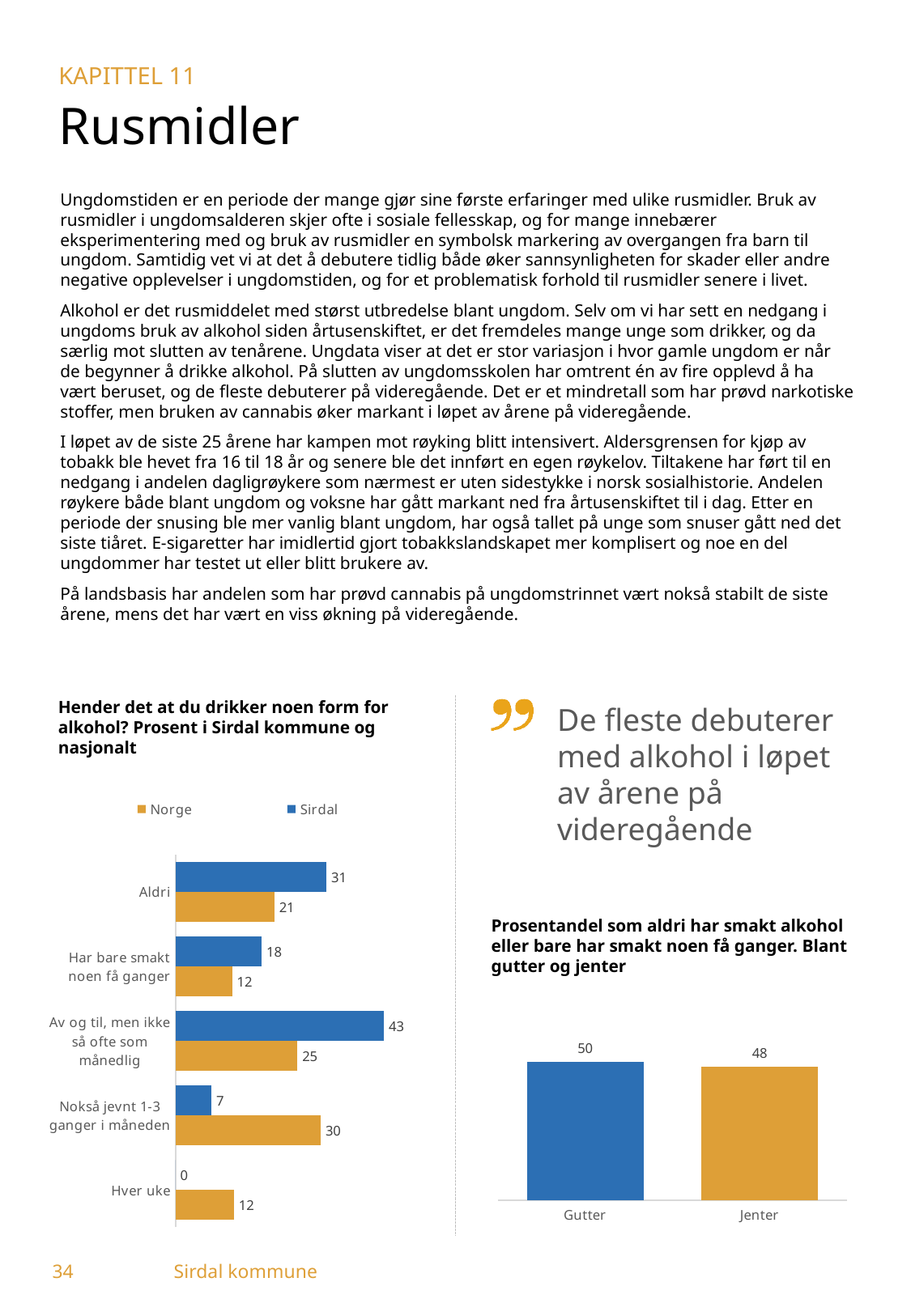
How many categories are shown in the chart 'Hender det at du drikker noen form for alkohol?'? 5 In the chart 'Hender det at du drikker noen form for alkohol?', what is the value for Sirdal in the category 'Hver uke'? 0 What kind of chart is the chart 'Hender det at du drikker noen form for alkohol?'? Bar chart In the chart 'Hender det at du drikker noen form for alkohol?', what is the difference between Sirdal and Norge in the category 'Av og til, men ikke så ofte som månedlig'? 18 In the chart 'Prosentandel som aldri har smakt alkohol eller bare har smakt noen få ganger', what is the difference between Gutter and Jenter? 2 In the chart 'Hender det at du drikker noen form for alkohol?', which category has the highest value for Sirdal? Av og til, men ikke så ofte som månedlig In the chart 'Hender det at du drikker noen form for alkohol?', what is the value for Sirdal in the category 'Aldri'? 31 In the chart 'Hender det at du drikker noen form for alkohol?', what is the value for Norge in the category 'Nokså jevnt 1-3 ganger i måneden'? 30 In the chart 'Hender det at du drikker noen form for alkohol?', which category has the lowest value for Norge? Har bare smakt noen få ganger and Hver uke (both 12) How many series does the legend list in the chart 'Hender det at du drikker noen form for alkohol?'? 2 In the chart 'Prosentandel som aldri har smakt alkohol eller bare har smakt noen få ganger', what is the value for Jenter? 48 In the chart 'Hender det at du drikker noen form for alkohol?', which is larger in the category 'Nokså jevnt 1-3 ganger i måneden', Sirdal or Norge? Norge